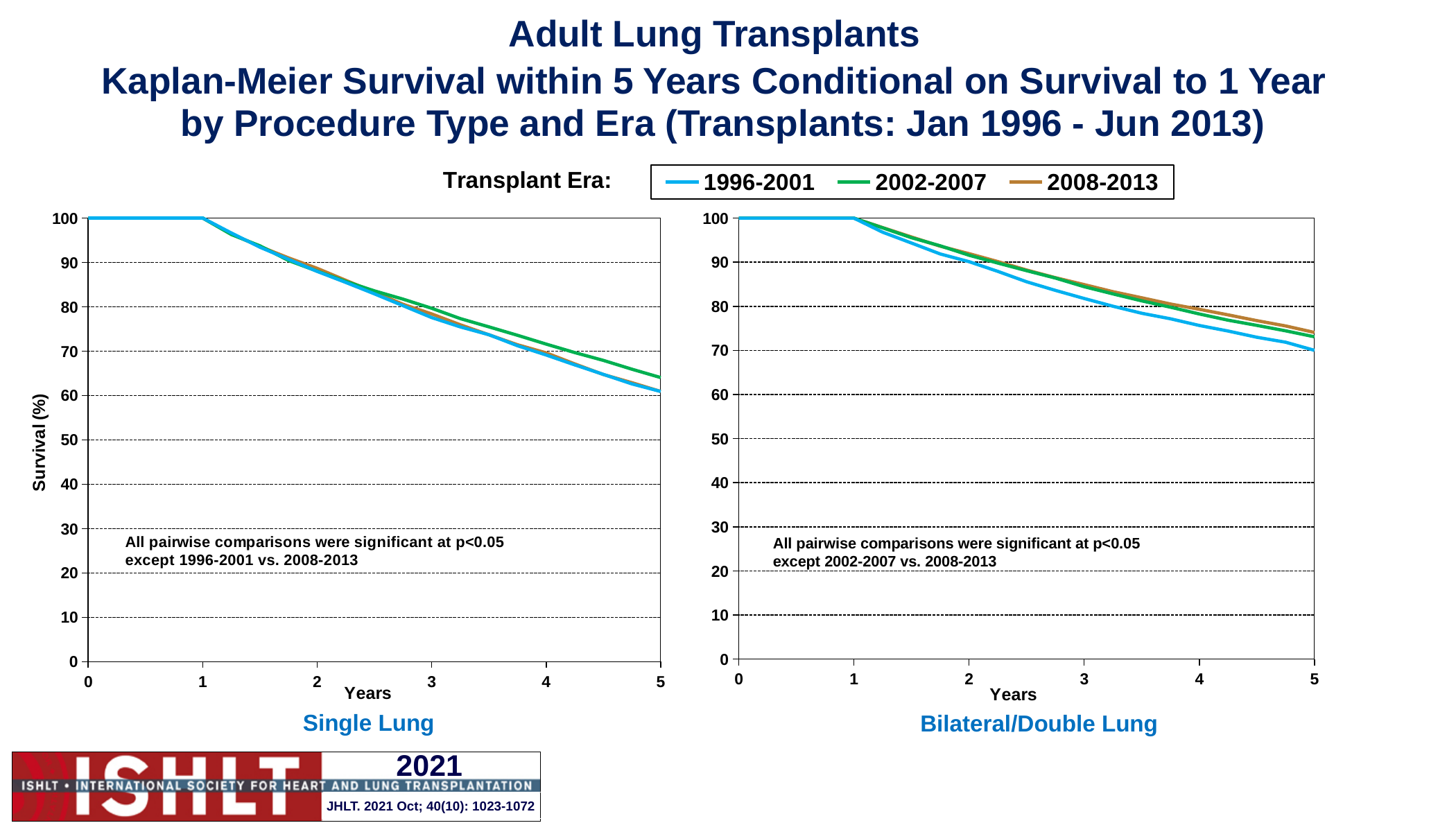
In the Bilateral/Double Lung chart, which era has the lowest survival at year 5? 1996-2001 How many transplant eras does the legend list? 3 What kind of chart is the Single Lung chart? line chart Which transplant eras are listed in the legend? 1996-2001, 2002-2007, 2008-2013 In the Single Lung chart, which era has the highest survival at year 5? 2002-2007 In the Single Lung chart, is the survival value for 2002-2007 at year 5 greater or less than 70? less In the Single Lung chart, is the survival value for 2002-2007 at year 5 greater or less than 60? greater In the Bilateral/Double Lung chart, do the survival curves rise or fall as years increase? fall What is the label on the y axis of the Single Lung chart? Survival (%) In the Single Lung chart, what is the survival value for all eras at year 1? 100 In the Bilateral/Double Lung chart, at year 5, which is larger: the survival for 2008-2013 or for 1996-2001? 2008-2013 In the Bilateral/Double Lung chart, is the survival value for 1996-2001 at year 4 greater or less than 80? less